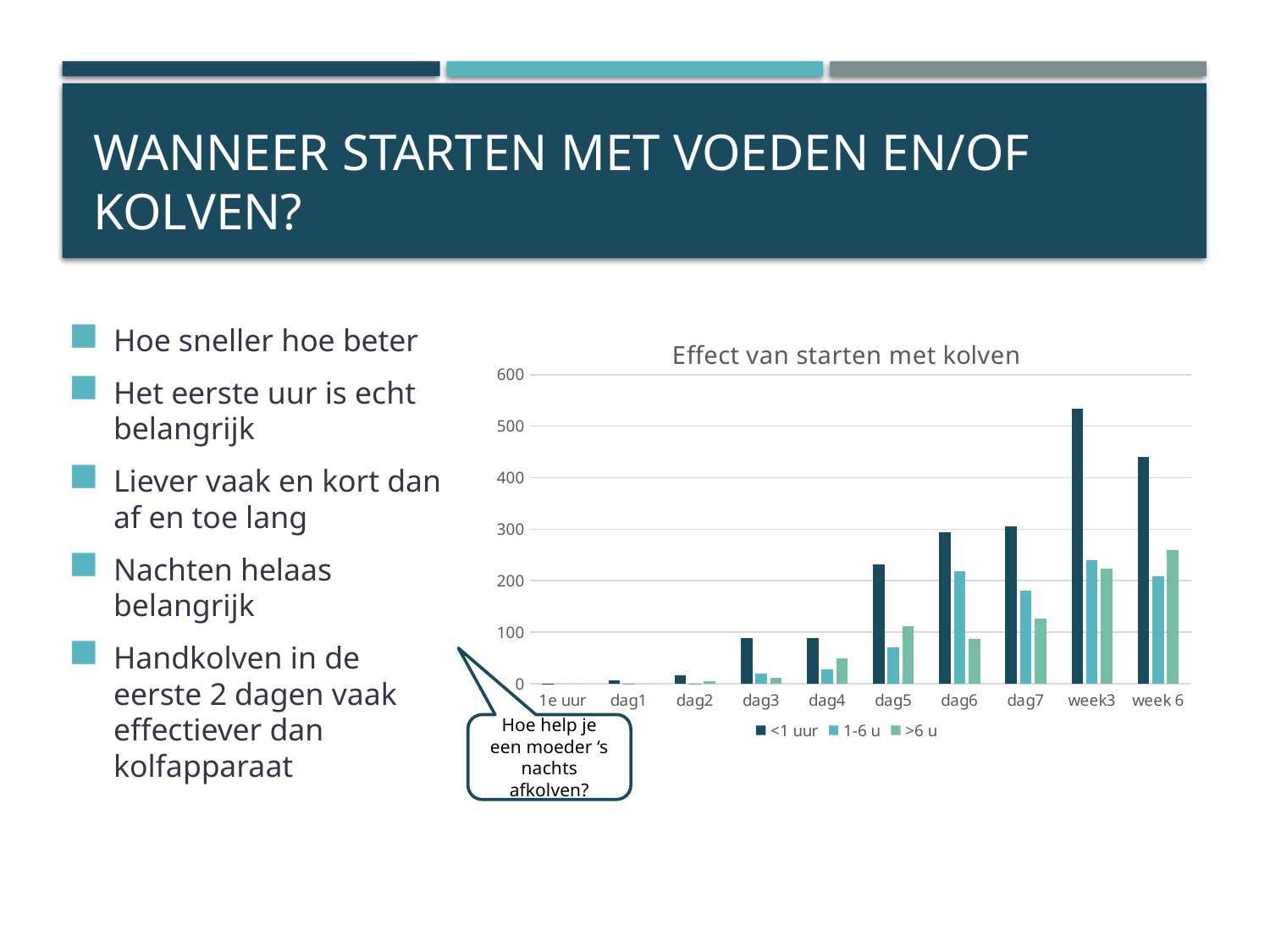
Which category has the highest value for the <1 uur series? week3 How many categories are shown on the x axis of the chart? 10 Is the value for <1 uur at dag3 greater or less than 100? less Is the value for 1-6 u at dag7 greater or less than 200? less What is the title of the chart? Effect van starten met kolven Is the value for <1 uur at week3 greater or less than 500? greater How many series does the chart legend list? 3 Do the values for the <1 uur series rise or fall from 1e uur to week3? rise What kind of chart is shown on the slide? bar chart Which is larger for the <1 uur series: week3 or week 6? week3